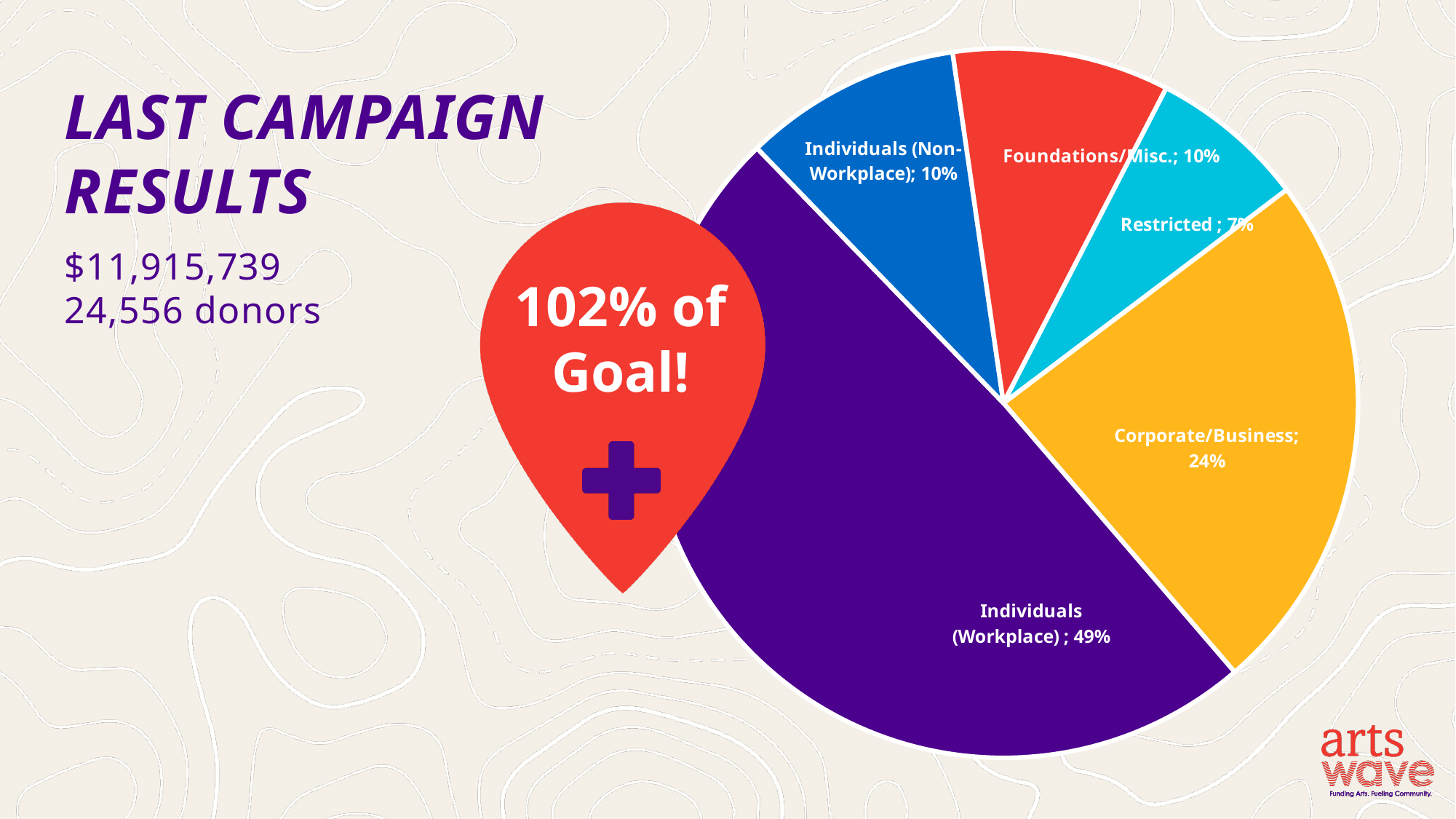
What share of the pie is Restricted? 7% Which is larger, Corporate/Business or Foundations/Misc.? Corporate/Business What is the difference in percentage points between Individuals (Workplace) and Corporate/Business? 25 What share of the pie is Individuals (Workplace)? 49% How many slices does the pie chart have? 5 What share of the pie is Individuals (Non-Workplace)? 10% What colour is the Corporate/Business slice? yellow What kind of chart is shown on the slide? pie chart Which slice of the pie is the smallest? Restricted Which slice of the pie is the largest? Individuals (Workplace)